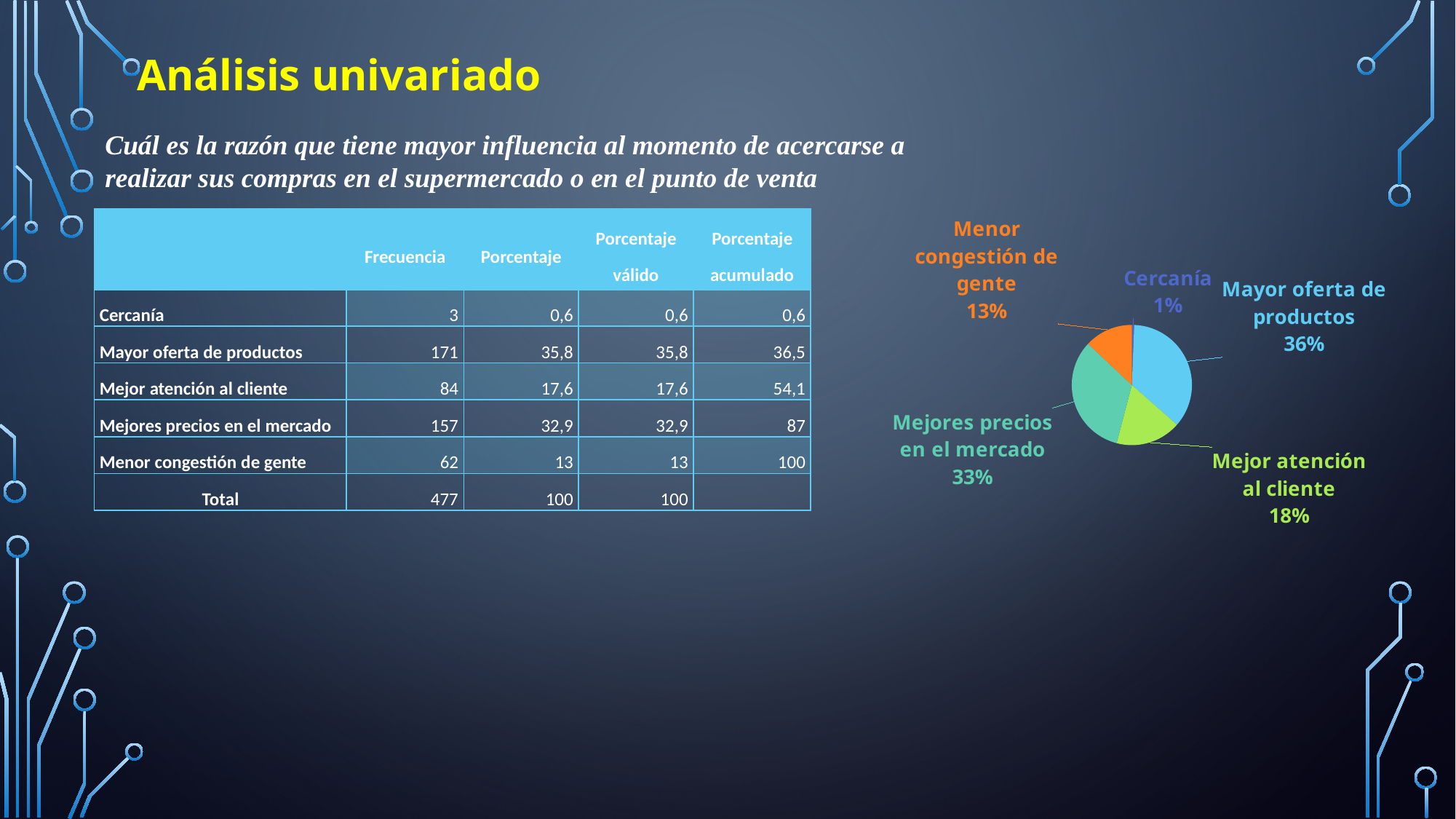
Which is larger in the pie chart, 'Mejores precios en el mercado' or 'Mejor atención al cliente'? Mejores precios en el mercado What kind of chart is shown on the slide? pie chart Which category has the smallest slice of the pie? Cercanía What share of the pie does 'Cercanía' have? 1% What share of the pie does 'Mejores precios en el mercado' have? 33% What share of the pie does 'Mejor atención al cliente' have? 18% What is the difference in percentage points between 'Mejor atención al cliente' and 'Menor congestión de gente'? 5 Which category has the largest slice of the pie? Mayor oferta de productos How many slices does the pie chart have? 5 What colour is the 'Menor congestión de gente' slice in the pie chart? orange